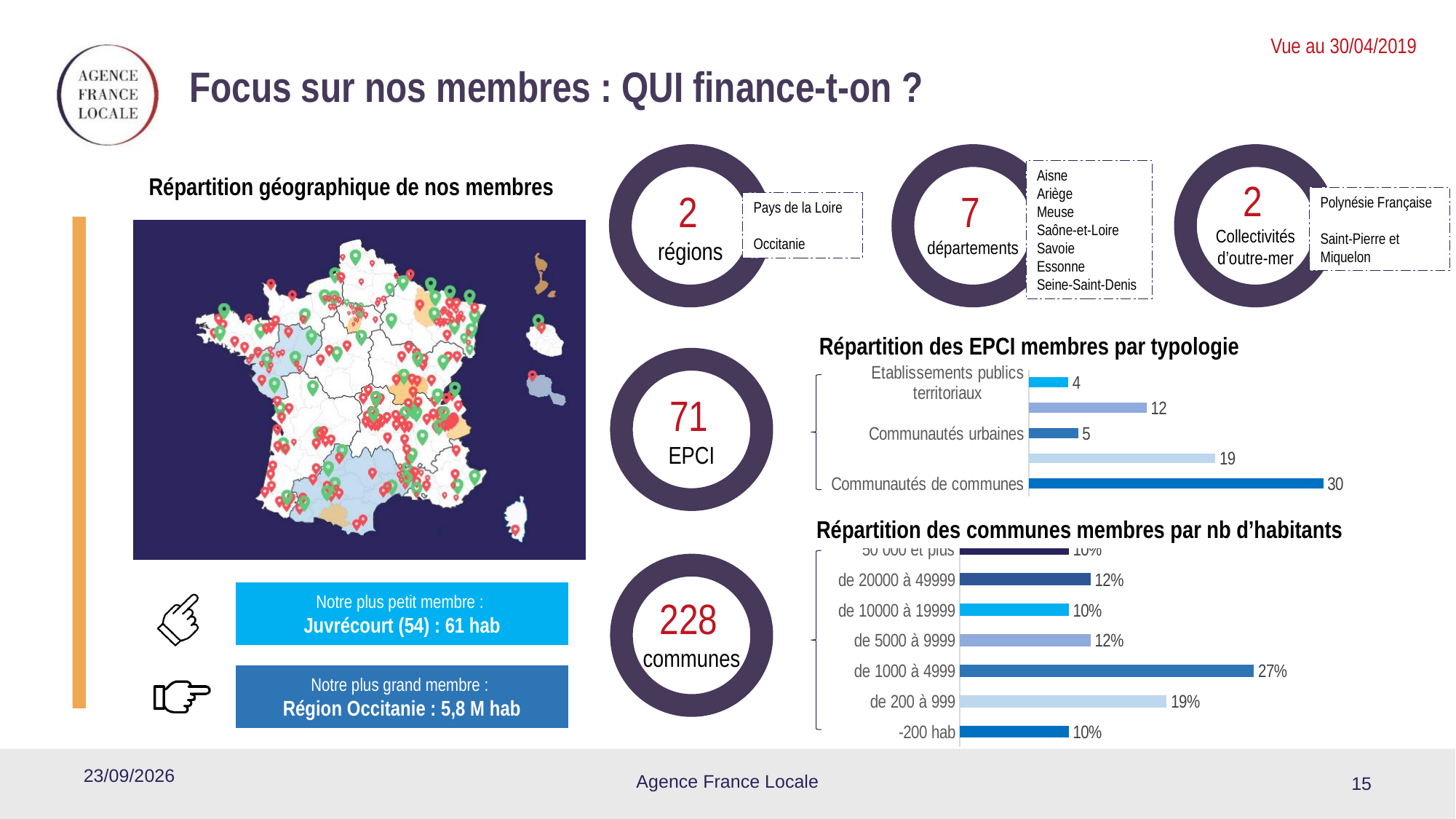
In the chart 'Répartition des EPCI membres par typologie', what is the value for Communautés urbaines? 5 In the chart 'Répartition des EPCI membres par typologie', which category has the highest value? Communautés de communes In the chart 'Répartition des EPCI membres par typologie', what is the difference between Communautés de communes and Communautés urbaines? 25 In the chart 'Répartition des communes membres par nb d'habitants', which category has the highest share? de 1000 à 4999 In the chart 'Répartition des EPCI membres par typologie', what is the value for Etablissements publics territoriaux? 4 What kind of chart is 'Répartition des communes membres par nb d'habitants'? bar chart In the chart 'Répartition des communes membres par nb d'habitants', how many population categories are shown? 7 In the chart 'Répartition des EPCI membres par typologie', what is the value for Communautés de communes? 30 In the chart 'Répartition des communes membres par nb d'habitants', which is larger: 'de 20000 à 49999' or '-200 hab'? de 20000 à 49999 In the chart 'Répartition des communes membres par nb d'habitants', what is the value for 'de 1000 à 4999'? 27% In the chart 'Répartition des EPCI membres par typologie', how many bars are plotted? 5 In the chart 'Répartition des communes membres par nb d'habitants', what is the value for 'de 200 à 999'? 19%